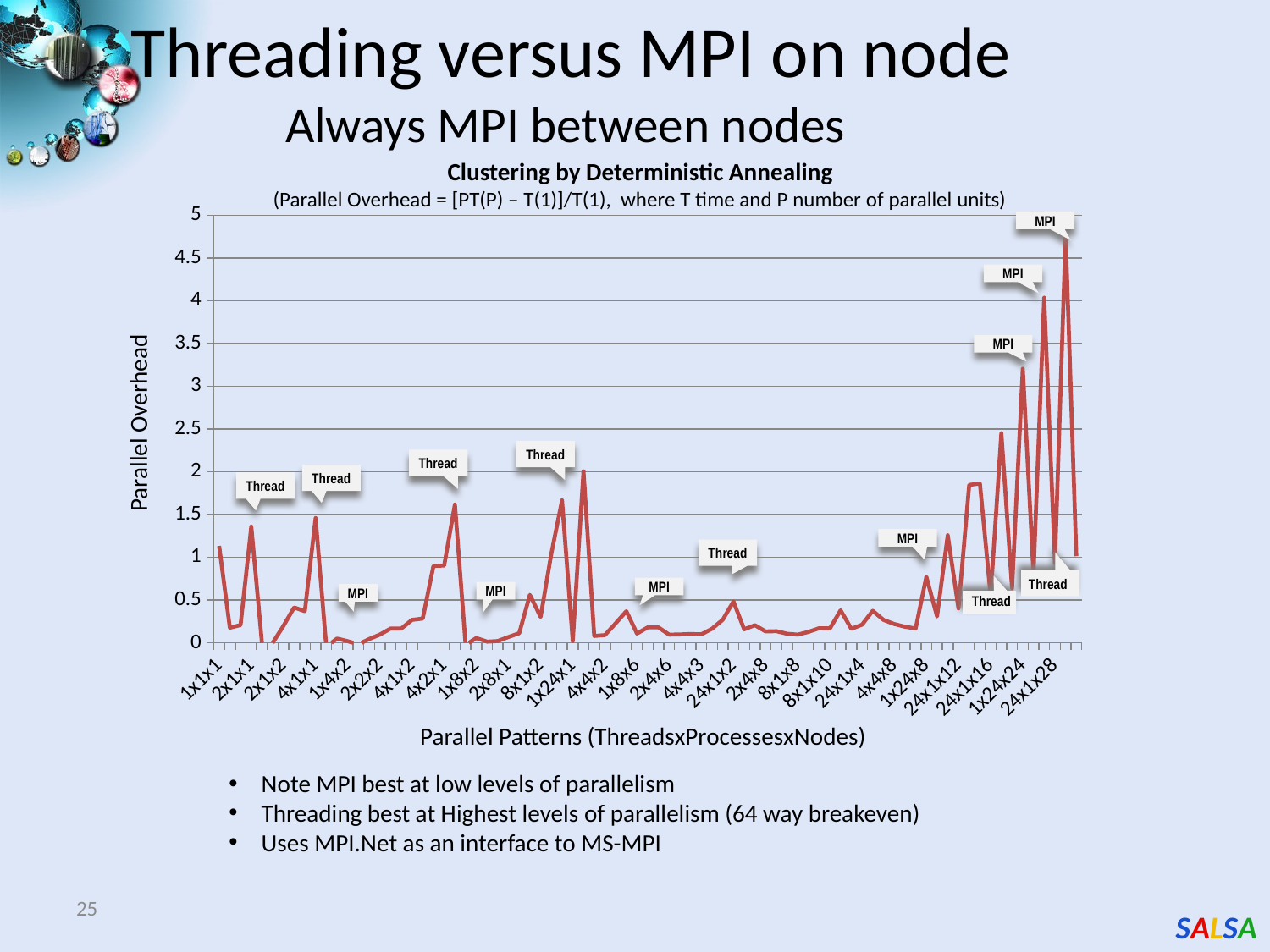
Which callout label, Thread or MPI, marks the highest peak on the chart? MPI Is the highest peak on the chart greater or less than 4.5? greater Is the tallest peak labelled MPI higher or lower than the tallest peak labelled Thread? higher What is the label on the vertical axis of the chart? Parallel Overhead What kind of chart is shown on the slide? line chart Is the value for 1x1x1 greater or less than 0.5? greater What is the highest tick value shown on the vertical axis? 5 What is the title of the chart? Clustering by Deterministic Annealing How many data series are plotted on the chart? 1 Do the peak values of the line generally rise or fall toward the right end of the x axis? rise Is the lowest value on the chart greater or less than 0.5? less